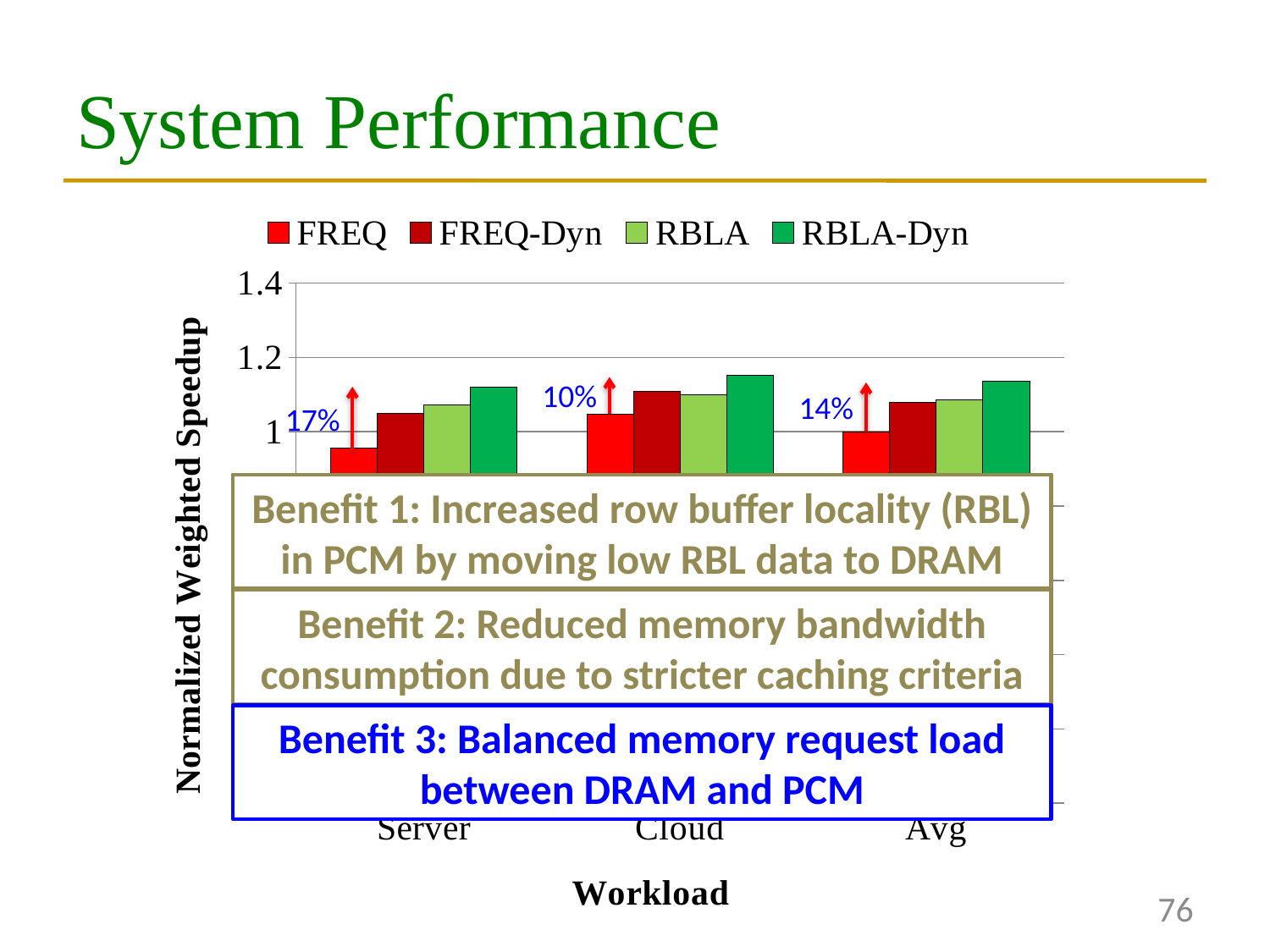
What is the title of the y axis? Normalized Weighted Speedup Which series has the lowest bar for the Server workload? FREQ How many series does the legend list? 4 How many workload categories are shown on the x axis? 3 What percentage improvement is annotated above the Server workload group? 17% Which series has the lowest bar for the Avg workload? FREQ Is the value for FREQ in the Server workload greater or less than 1? less Which series has the highest bar for the Server workload? RBLA-Dyn Is the value for RBLA-Dyn in the Cloud workload greater or less than 1.2? less What kind of chart is shown on the slide? bar chart Which series has the highest bar for the Cloud workload? RBLA-Dyn Which is larger for the Server workload, the FREQ bar or the RBLA-Dyn bar? RBLA-Dyn